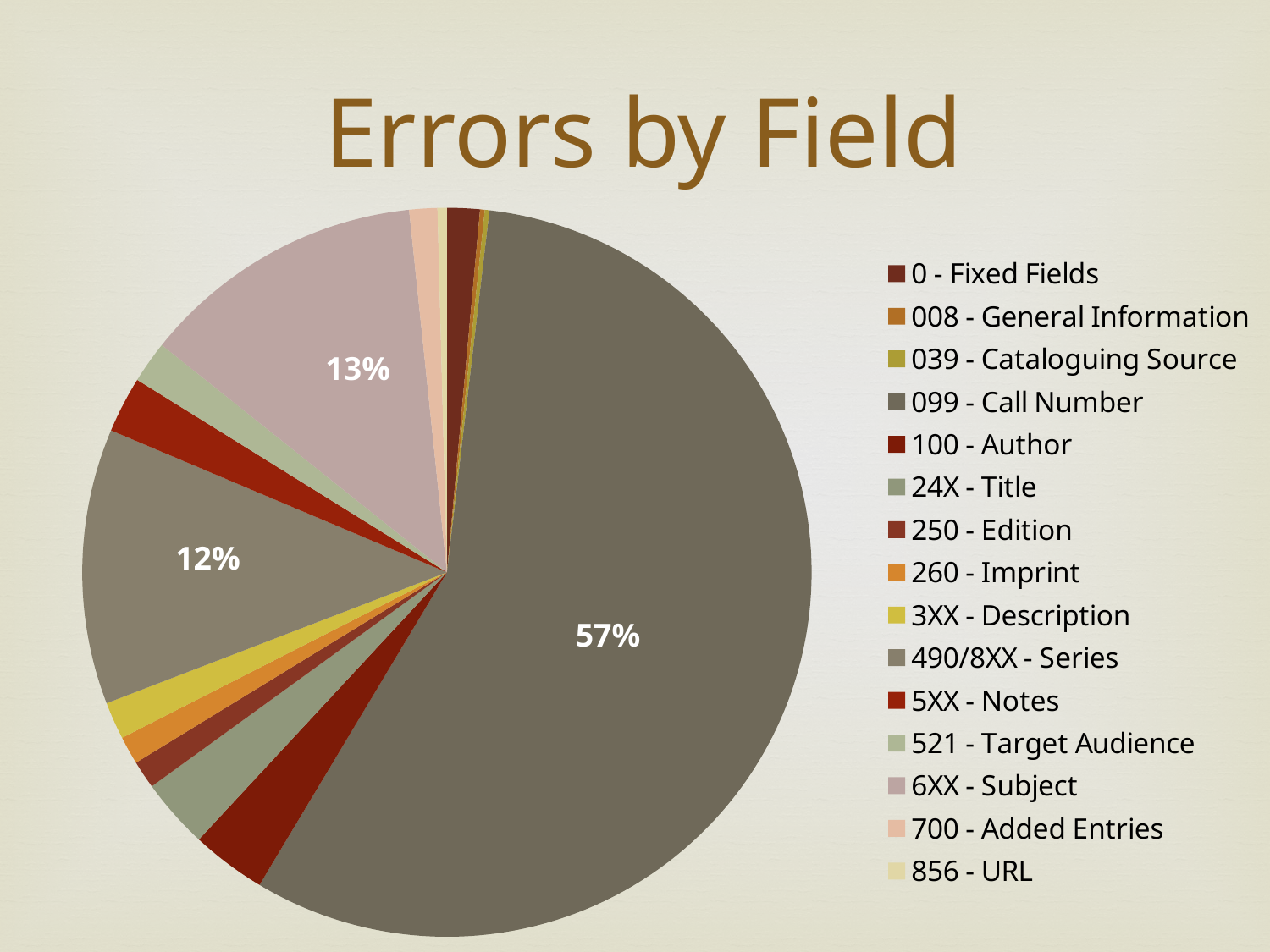
Which slice is larger, 6XX - Subject or 490/8XX - Series? 6XX - Subject How many slices have a percentage label printed on the chart? 3 Which field accounts for the largest share of errors? 099 - Call Number What kind of chart is shown on the slide? pie chart Which slice is larger, 099 - Call Number or 490/8XX - Series? 099 - Call Number What percentage is shown for the 6XX - Subject slice? 13% What is the title of the chart? Errors by Field What percentage is shown for the 490/8XX - Series slice? 12% What is the difference in percentage points between the 6XX - Subject slice and the 490/8XX - Series slice? 1 percentage point What is the difference in percentage points between the 099 - Call Number slice and the 6XX - Subject slice? 44 percentage points How many entries does the legend list? 15 What share of errors is attributed to 099 - Call Number? 57%